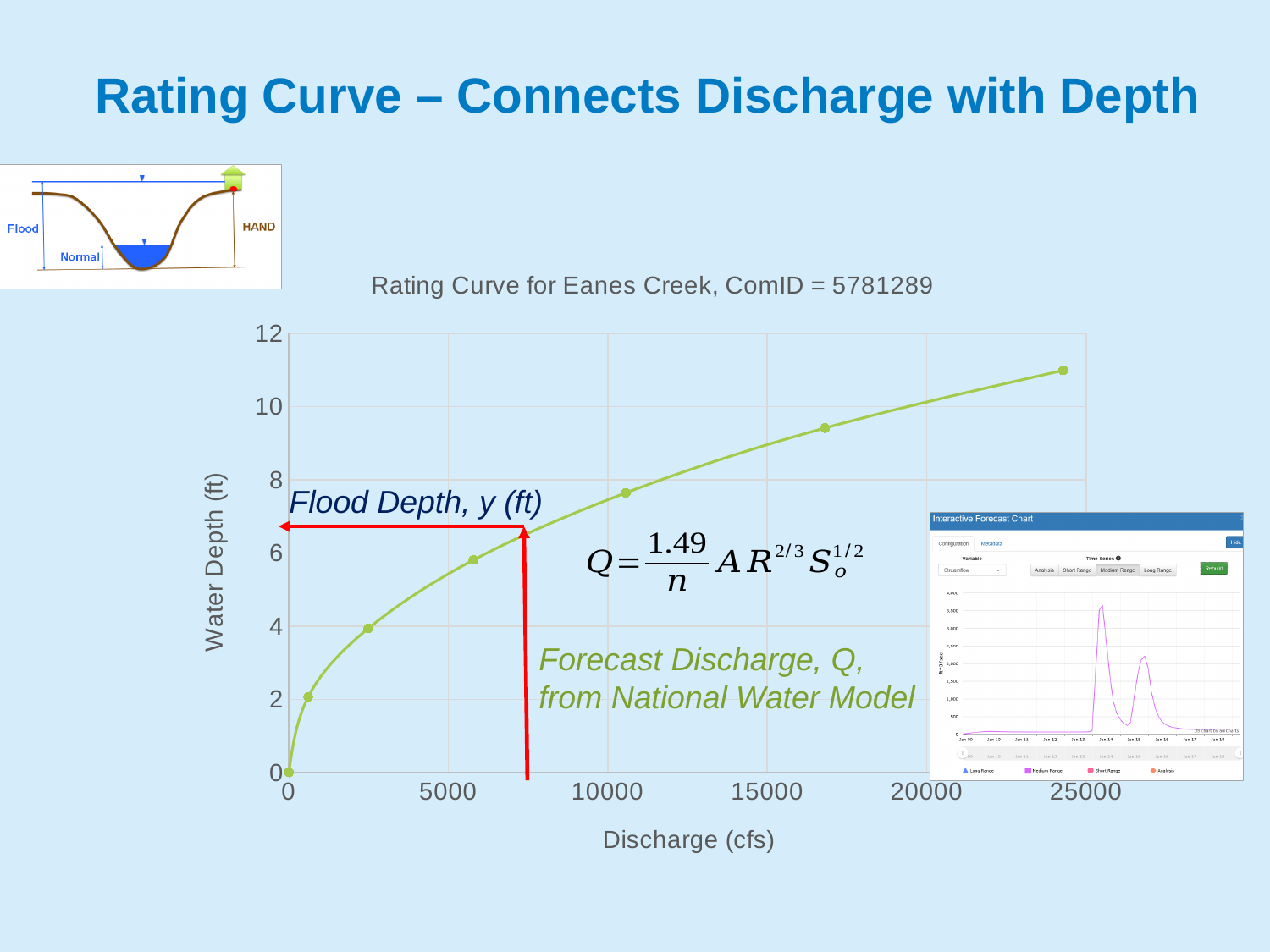
What kind of chart is the Rating Curve for Eanes Creek? line chart How many data points are marked on the Rating Curve for Eanes Creek line? 7 In the Rating Curve for Eanes Creek chart, is the water depth at a discharge of 5000 cfs greater or less than 4 ft? greater What is the title of the main chart on the slide? Rating Curve for Eanes Creek, ComID = 5781289 In the Rating Curve for Eanes Creek chart, is the water depth at a discharge of 15000 cfs greater or less than 8 ft? greater What is the label of the y axis on the Rating Curve for Eanes Creek chart? Water Depth (ft) In the Rating Curve for Eanes Creek chart, is the water depth at a discharge of 2500 cfs greater or less than 2 ft? greater In the Rating Curve for Eanes Creek chart, does water depth rise or fall as discharge increases along the x axis? rise